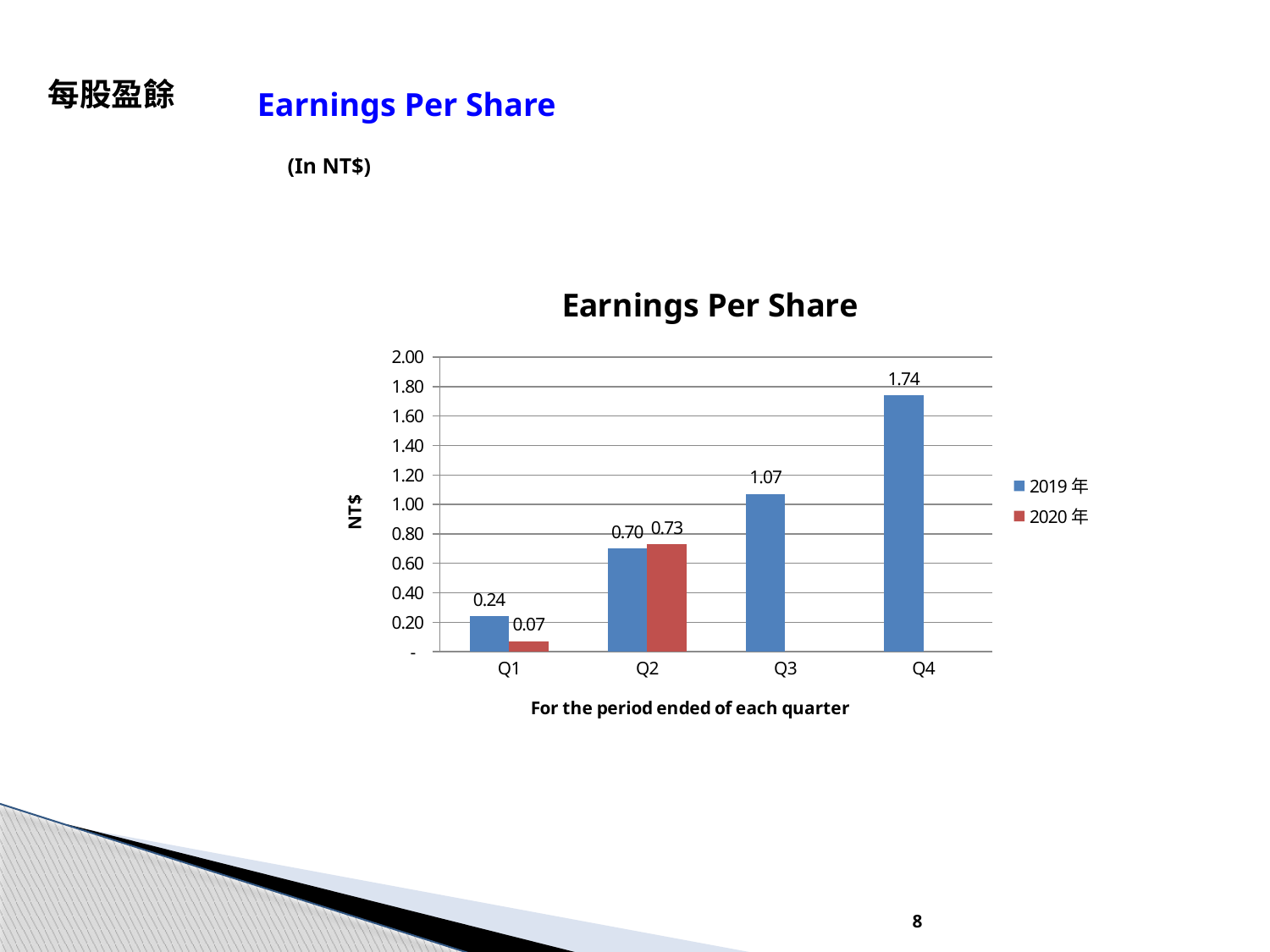
What is the 2019 年 earnings per share value for Q1? 0.24 Which quarter has the lowest 2019 年 earnings per share? Q1 What is the difference between the 2019 年 Q4 and Q3 earnings per share values? 0.67 How many quarters are shown on the x axis of the chart? 4 What is the 2020 年 earnings per share value for Q2? 0.73 What is the 2019 年 earnings per share value for Q4? 1.74 What is the difference between the 2019 年 and 2020 年 earnings per share values for Q1? 0.17 Is the 2019 年 earnings per share value for Q3 greater or less than 1.00? greater In Q2, which series has the larger earnings per share, 2019 年 or 2020 年? 2020 年 What type of chart is used to show Earnings Per Share? Bar chart How many series does the chart legend list? 2 Which quarter has the highest 2019 年 earnings per share? Q4